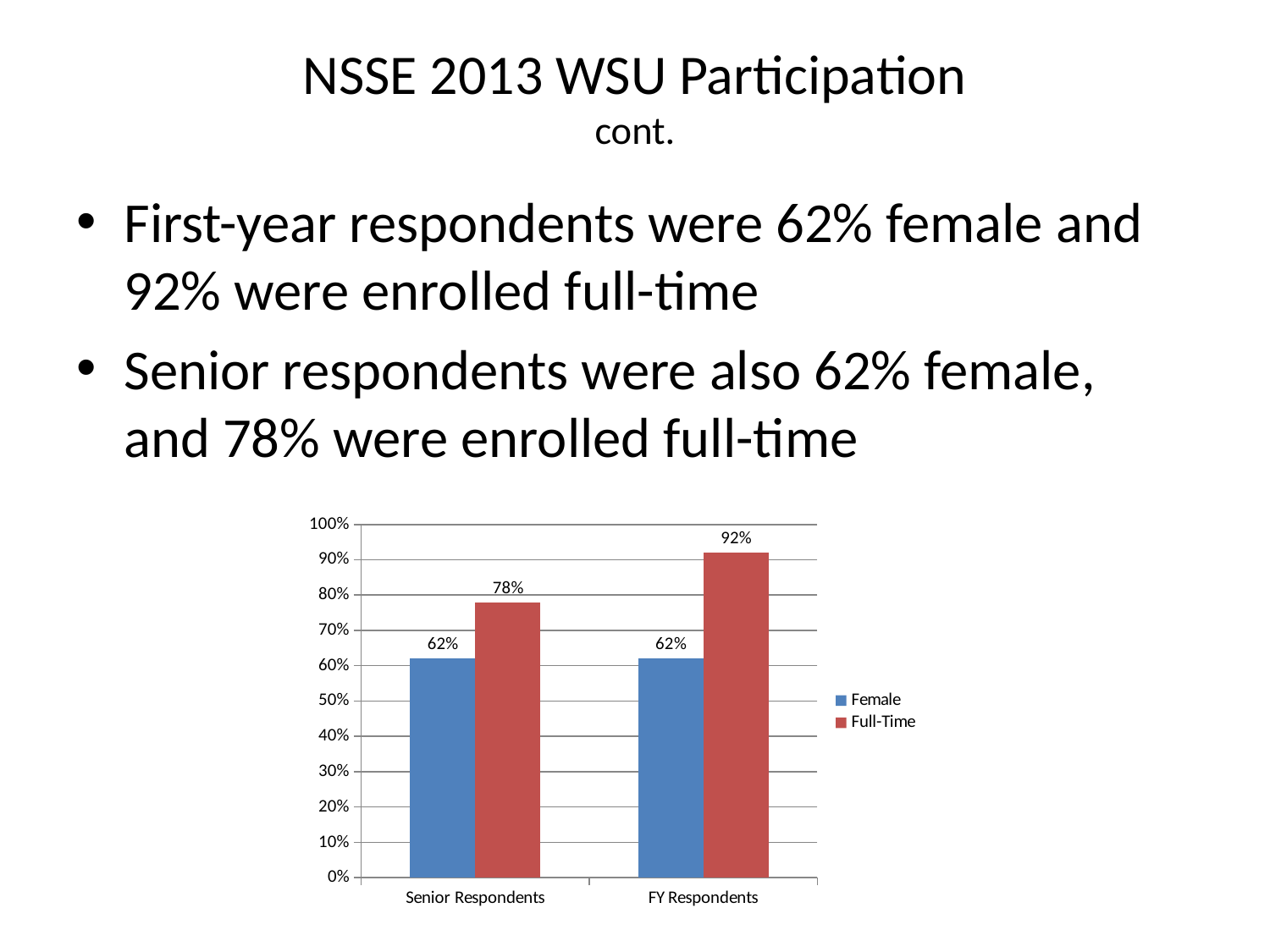
What is the difference between the Full-Time and Female values for Senior Respondents? 16% How many categories are shown on the x axis? 2 What is the Female value for Senior Respondents? 62% What kind of chart is shown on the slide? bar chart What is the Female value for FY Respondents? 62% Is the Full-Time value for FY Respondents greater or less than 90%? greater What is the difference between the Full-Time values for FY Respondents and Senior Respondents? 14% How many series does the legend list? 2 What is the Full-Time value for Senior Respondents? 78% Which category has the highest Full-Time value? FY Respondents What is the Full-Time value for FY Respondents? 92% Which is larger for FY Respondents, the Female value or the Full-Time value? Full-Time